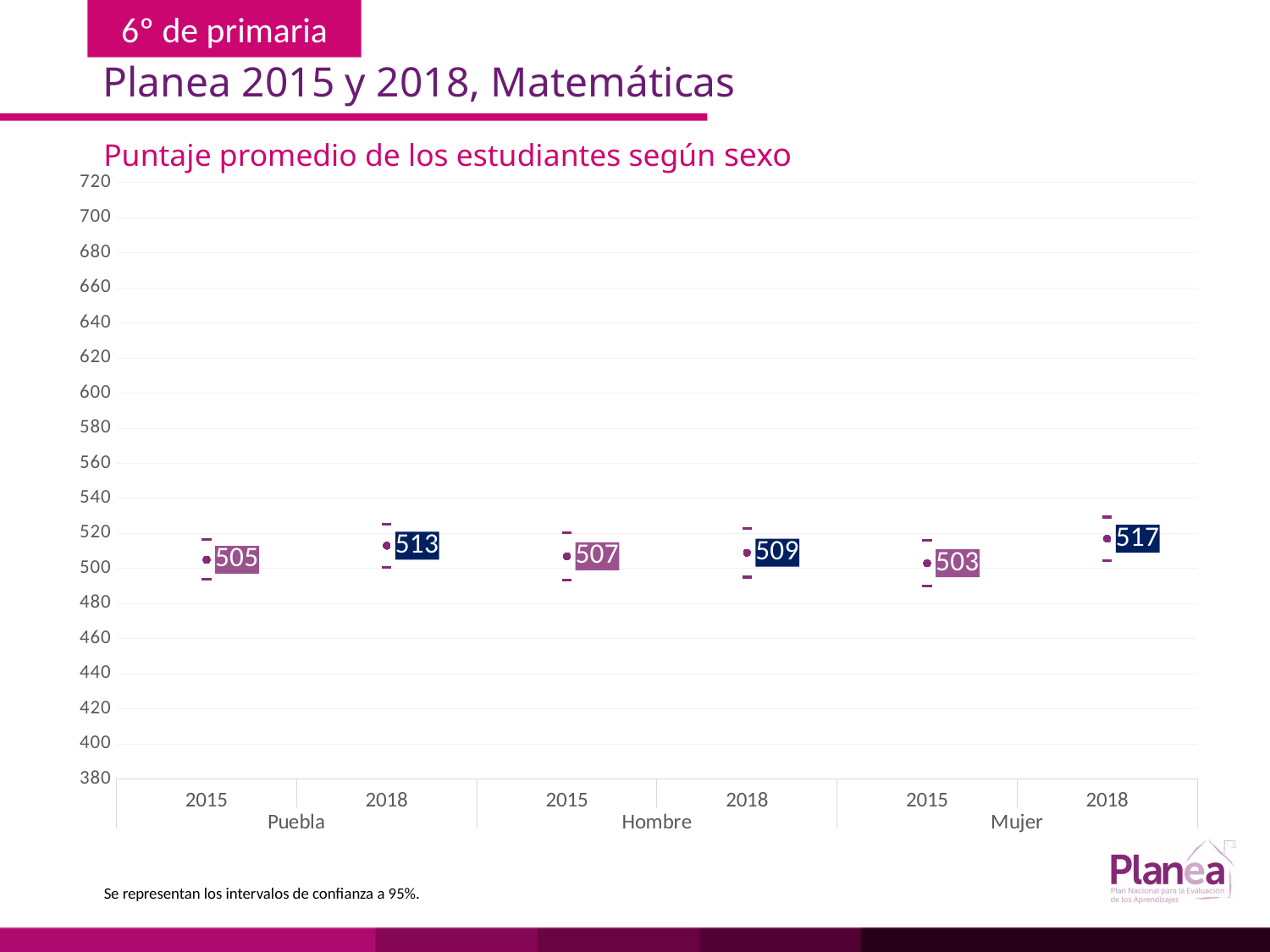
What is the difference between the Puebla scores in 2018 and 2015? 8 Which is larger, the 2018 score for Hombre or the 2018 score for Mujer? Mujer By how many points did the average score for Mujer increase from 2015 to 2018? 14 What is the average score for Puebla in 2015? 505 Do the scores rise or fall from 2015 to 2018 for each group? rise What is the average score for Hombre in 2015? 507 Which group and year has the lowest average score? Mujer 2015 What is the title of the chart? Puntaje promedio de los estudiantes según sexo What is the average score for Hombre in 2018? 509 What is the average score for Mujer in 2018? 517 How many data points are plotted on the chart? 6 Which group and year has the highest average score? Mujer 2018